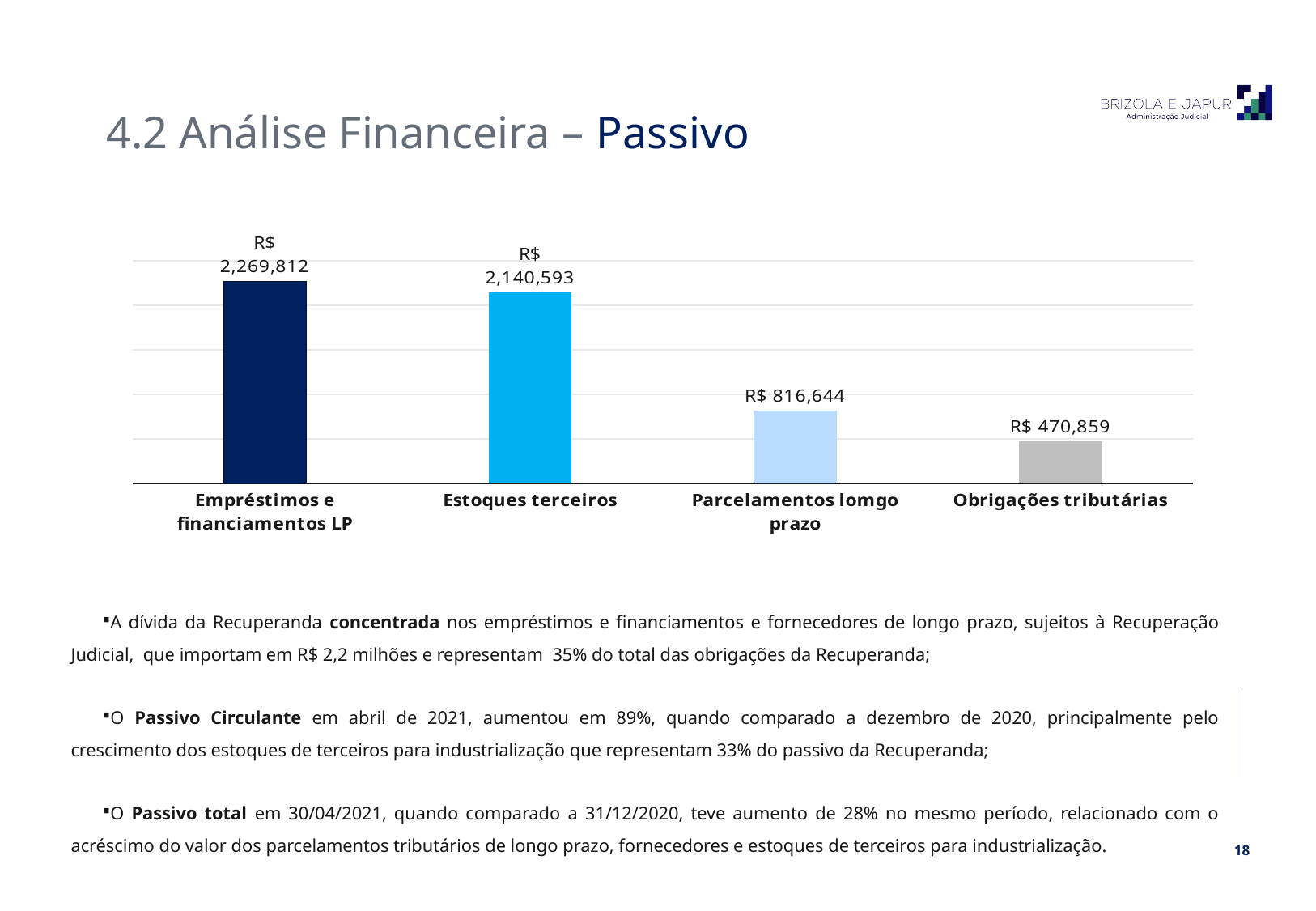
Which category has the highest value? Empréstimos e financiamentos LP What is the difference between Parcelamentos lomgo prazo and Obrigações tributárias? R$ 345,785 Which is larger, Estoques terceiros or Parcelamentos lomgo prazo? Estoques terceiros What is the value for Obrigações tributárias? R$ 470,859 What is the value for Parcelamentos lomgo prazo? R$ 816,644 What is the value for Estoques terceiros? R$ 2,140,593 How many categories are shown in the chart? 4 Do the values rise or fall from left to right across the categories? Fall What is the difference between Empréstimos e financiamentos LP and Estoques terceiros? R$ 129,219 What kind of chart is shown on the slide? Bar chart Which category has the lowest value? Obrigações tributárias What is the value for Empréstimos e financiamentos LP? R$ 2,269,812